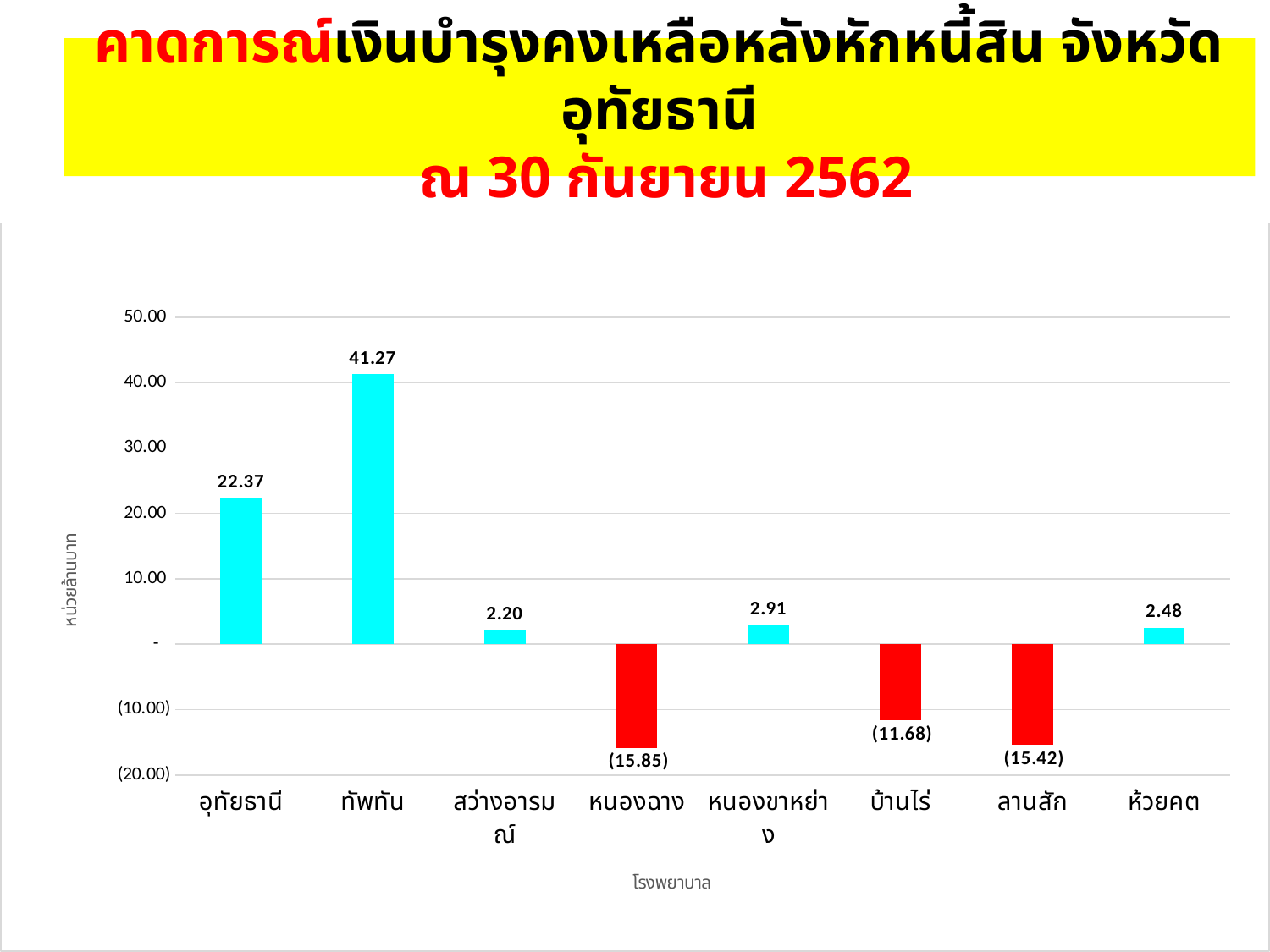
What is the value shown for บ้านไร่? (11.68) What is the value for ห้วยคต? 2.48 Which hospital has the highest value? ทัพทัน What is the value for อุทัยธานี? 22.37 How many hospitals are shown on the x axis? 8 What is the difference between the values for ทัพทัน and อุทัยธานี? 18.90 Which is larger, the value for หนองขาหย่าง or the value for สว่างอารมณ์? หนองขาหย่าง What kind of chart is shown on the slide? bar chart What is the value for ทัพทัน? 41.27 Is the value for ทัพทัน greater or less than 40.00? greater What is the value shown for หนองฉาง? (15.85) Which hospital has the lowest value? หนองฉาง